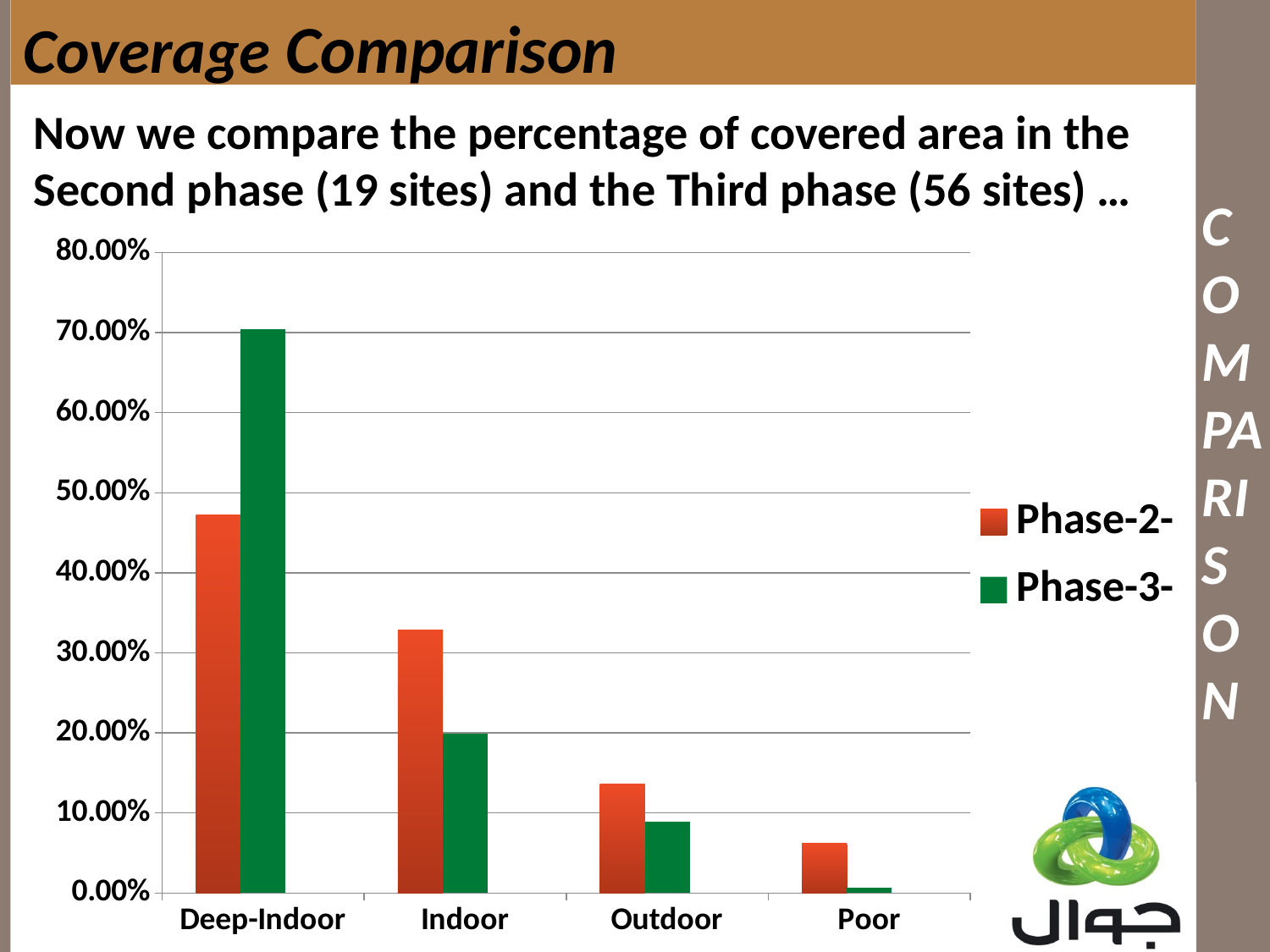
For Indoor, which series has the larger value, Phase-2- or Phase-3-? Phase-2- How many categories are shown on the x axis? 4 Which category has the lowest Phase-3- value? Poor Which series is shown in green in the legend? Phase-3- Is the Phase-3- value for Outdoor greater or less than 10.00%? less Which category has the highest Phase-3- value? Deep-Indoor Is the Phase-2- value for Indoor greater or less than 30.00%? greater Which category has the lowest Phase-2- value? Poor What kind of chart is shown on the slide? bar chart How many series does the legend list? 2 Is the Phase-2- value for Deep-Indoor greater or less than 50.00%? less